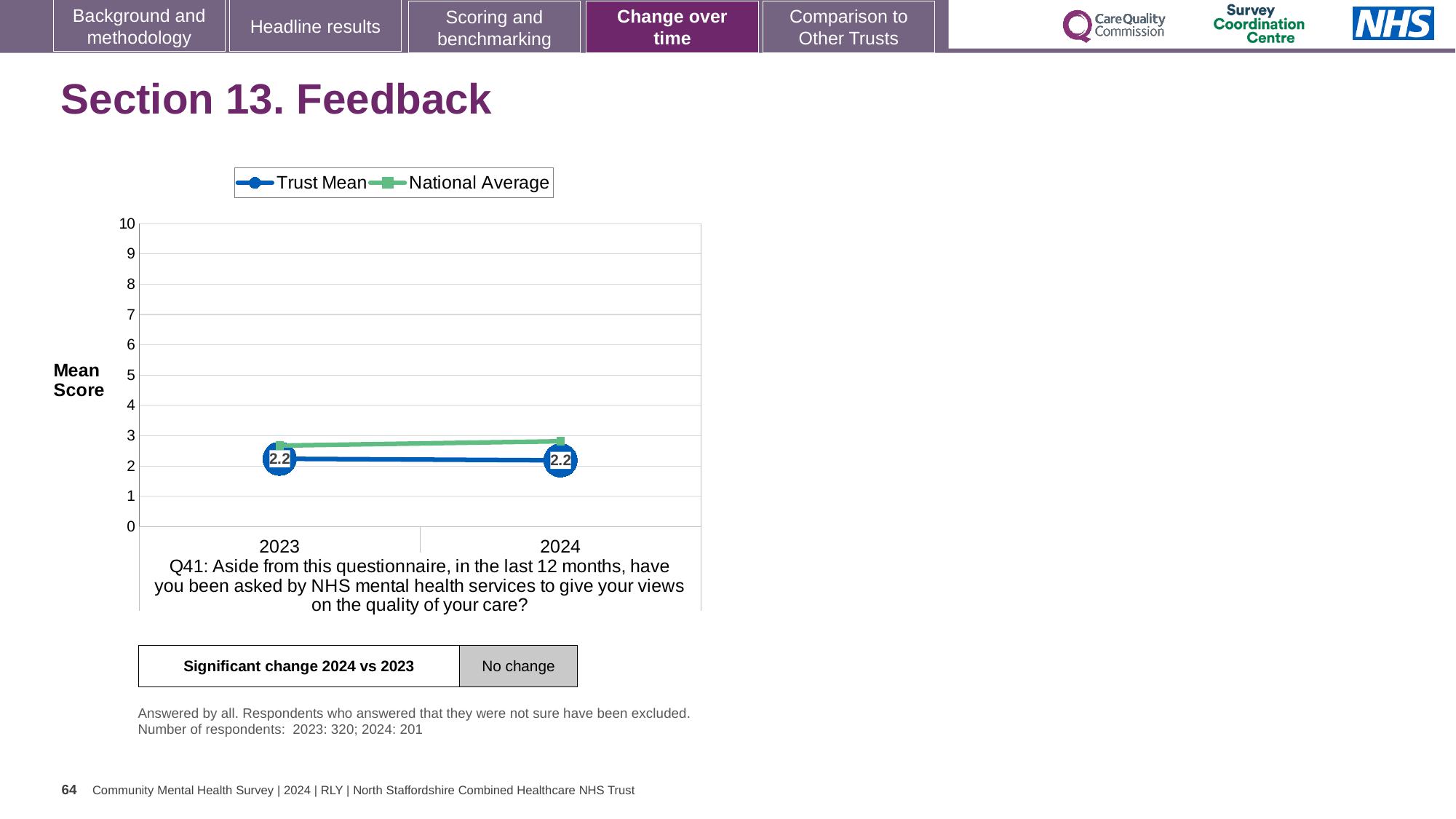
What kind of chart is shown on the slide? Line chart What is the difference between the Trust Mean in 2024 and the Trust Mean in 2023? 0 What is the label on the y axis of the chart? Mean Score In 2023, which is higher: the Trust Mean or the National Average? National Average In 2024, which is higher: the Trust Mean or the National Average? National Average Is the National Average value for 2023 greater or less than 2? greater How many years are plotted on the x axis of the chart? 2 What is the Trust Mean value for 2024? 2.2 Is the National Average value for 2024 greater or less than 5? less How many series does the chart legend list? 2 Does the Trust Mean rise, fall or stay the same from 2023 to 2024? Stays the same What is the Trust Mean value for 2023? 2.2